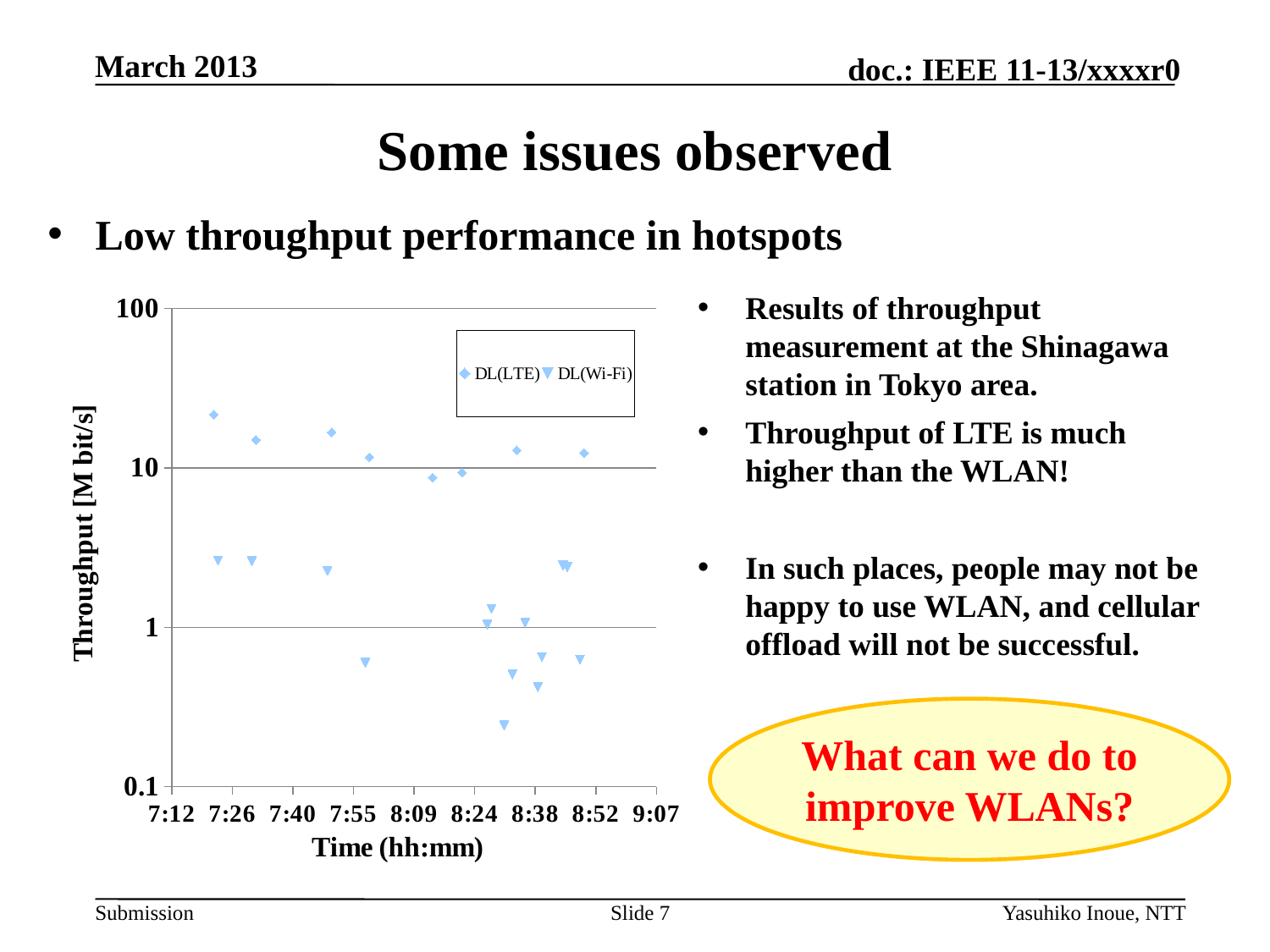
What kind of chart is shown on the slide? Scatter chart Is the lowest DL(LTE) value greater or less than 1? greater Which series has the higher throughput values overall, DL(LTE) or DL(Wi-Fi)? DL(LTE) What are the two series named in the chart legend? DL(LTE) and DL(Wi-Fi) What is the label of the chart's vertical axis? Throughput [M bit/s] How many DL(LTE) points are plotted on the chart? 8 Is the highest DL(LTE) value greater or less than 10? greater Which series contains the highest plotted throughput value? DL(LTE) Is the highest DL(Wi-Fi) value greater or less than 10? less How many series does the chart legend list? 2 Which series contains the lowest plotted throughput value? DL(Wi-Fi)